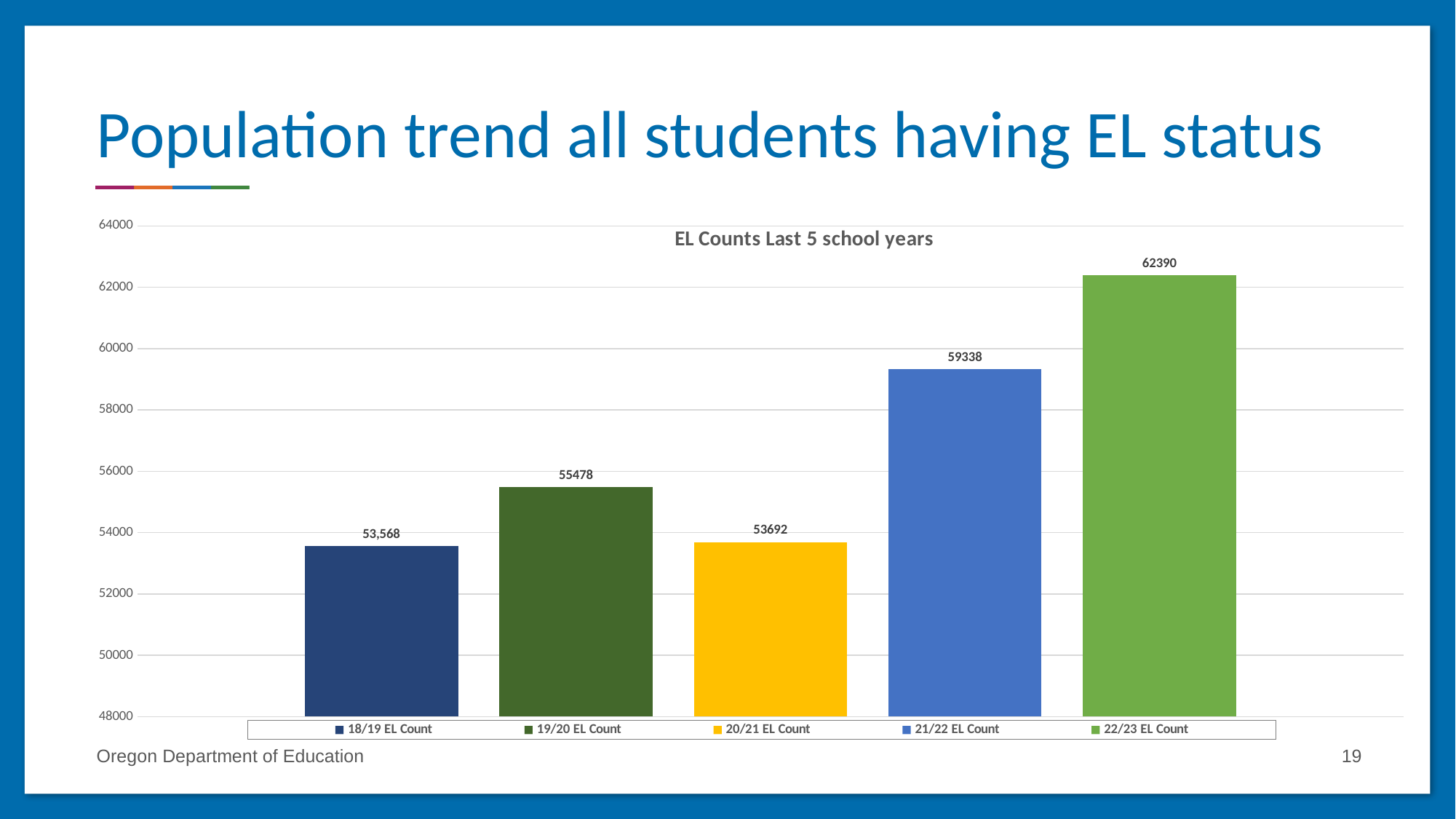
Which is larger, the 19/20 EL Count or the 21/22 EL Count? 21/22 EL Count What is the difference between the 19/20 EL Count and the 20/21 EL Count? 1786 What is the value for 20/21 EL Count? 53692 How many bars are shown in the chart? 5 What is the value for 21/22 EL Count? 59338 Which school year has the highest EL count? 22/23 EL Count What is the value for 22/23 EL Count? 62390 Which school year has the lowest EL count? 18/19 EL Count What is the title of the chart? EL Counts Last 5 school years What is the difference between the 22/23 EL Count and the 21/22 EL Count? 3052 What is the value for 18/19 EL Count? 53,568 How many entries does the legend list? 5